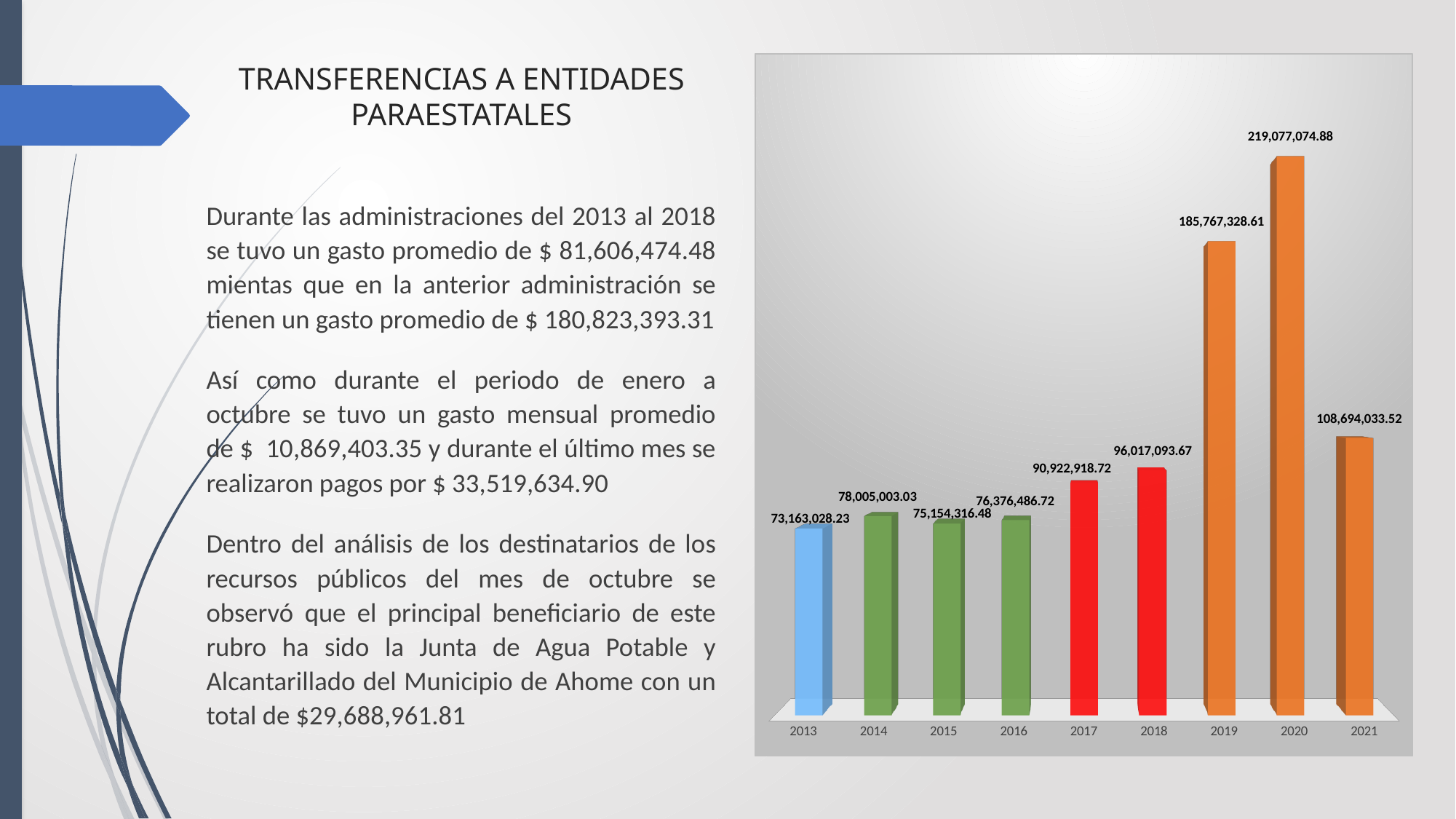
What kind of chart is shown on the slide? Bar chart What is the value shown for 2020? 219,077,074.88 How many years are shown on the x axis of the chart? 9 What is the difference between the values for 2020 and 2019? 33,309,746.27 What is the value shown for 2021? 108,694,033.52 Which is larger, the value for 2019 or the value for 2021? 2019 Which year has the lowest value? 2013 What is the value shown for 2013? 73,163,028.23 What is the difference between the values for 2018 and 2017? 5,094,174.95 What is the value shown for 2017? 90,922,918.72 Which year has the highest value? 2020 What colour are the bars for 2019, 2020 and 2021? Orange